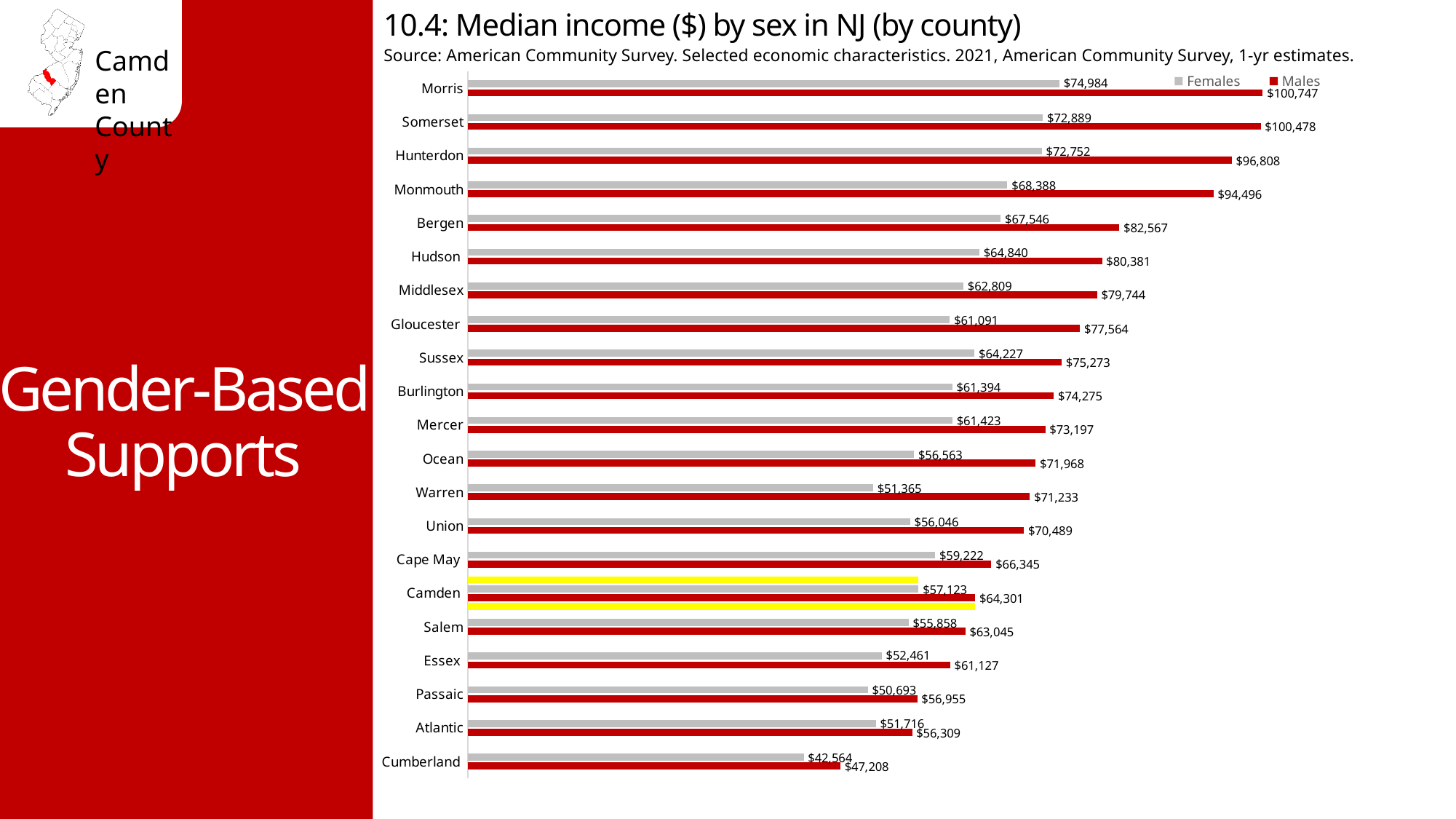
What is the median income for males in Hunterdon County? $96,808 How many counties are shown in the chart? 21 Which county has the lowest median income for females? Cumberland What is the difference between male and female median income in Camden County? $7,178 Which colour represents Females in the chart? Gray What type of chart is shown on the slide? Bar chart Which county has the highest median income for males? Morris What is the median income for females in Morris County? $74,984 What is the median income for males in Camden County? $64,301 Which is larger: the female median income in Sussex County or in Middlesex County? Sussex How many series does the legend list? 2 What is the median income for females in Cumberland County? $42,564